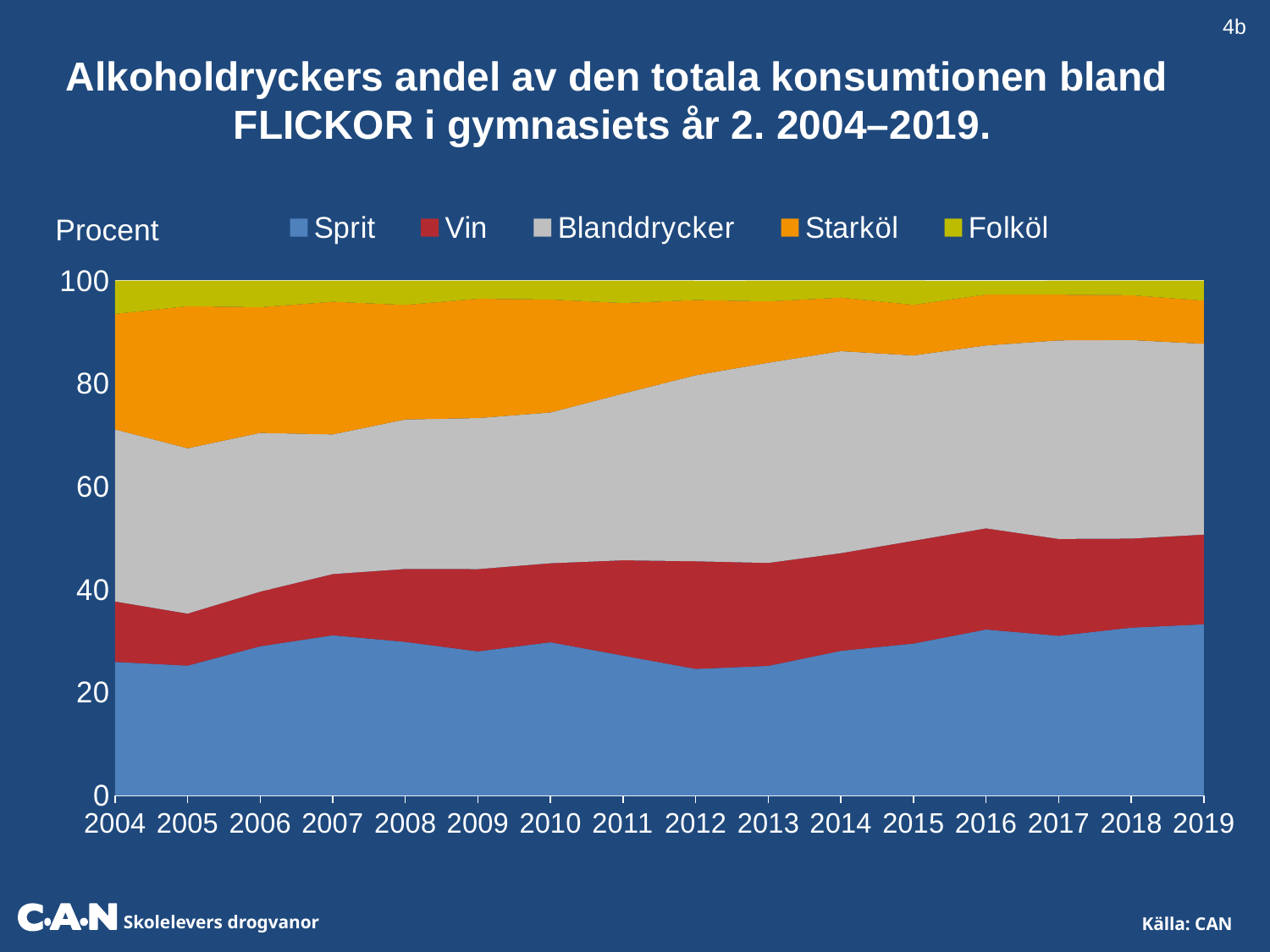
Is the value for Sprit in 2019 greater or less than 20? greater Is the value for Sprit in 2012 greater or less than 40? less Which is larger, the share for Starköl in 2004 or in 2019? 2004 Does the share for Sprit rise or fall from 2004 to 2019? rise Which series are listed in the legend? Sprit, Vin, Blanddrycker, Starköl, Folköl Does the share for Starköl rise or fall from 2004 to 2019? fall How many years are shown along the x axis? 16 Which series has the smallest share in 2004? Folköl Is the value for Sprit in 2004 greater or less than 40? less How many series does the legend list? 5 What is the label of the y axis? Procent What kind of chart is shown on the slide? Stacked area chart